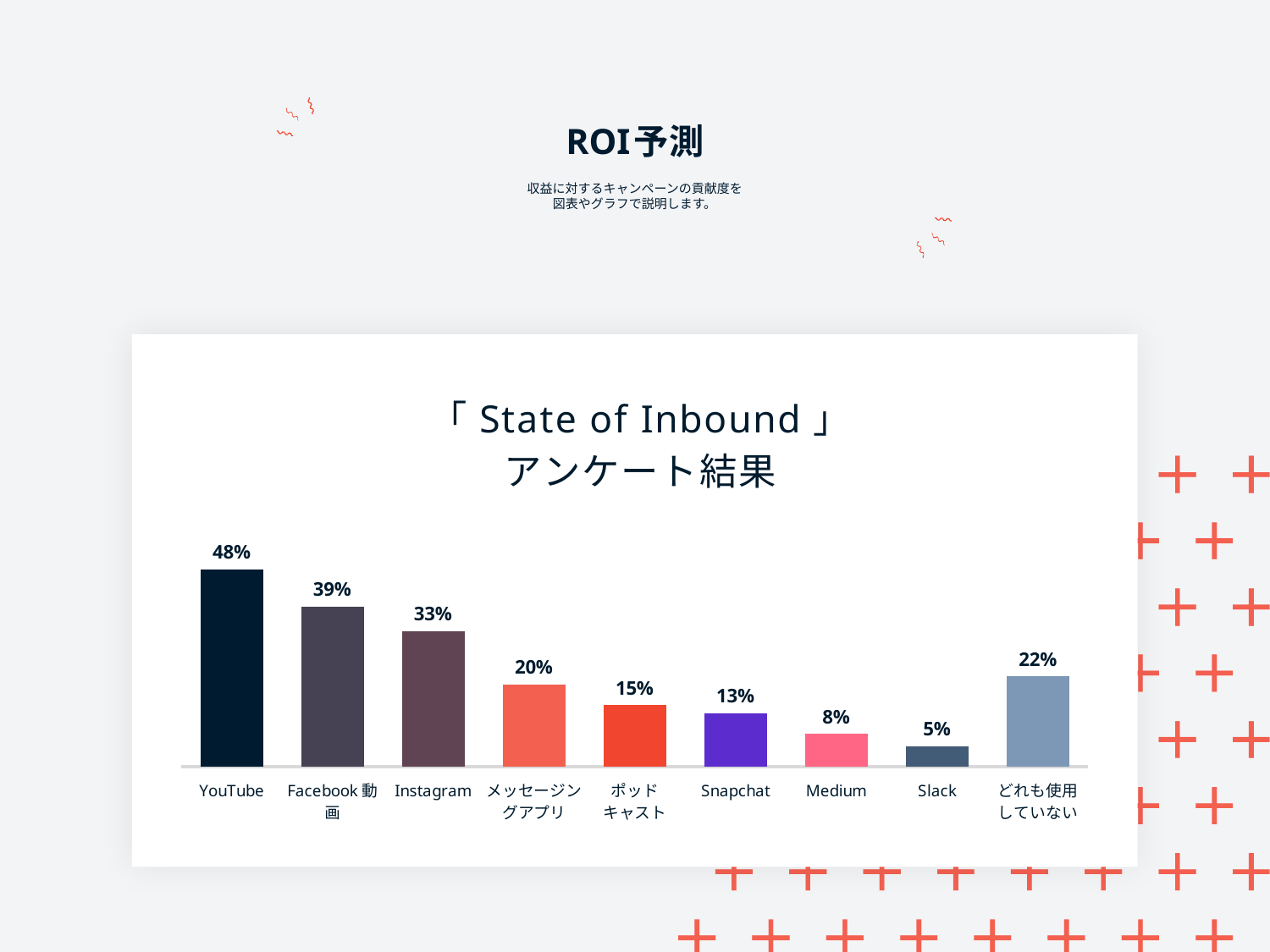
Which is larger, the value for ポッドキャスト or the value for どれも使用していない? どれも使用していない What kind of chart is shown on the slide? Bar chart What is the difference between the values for Instagram and Medium? 25% What is the value for どれも使用していない? 22% Which is larger, the value for メッセージングアプリ or the value for Snapchat? メッセージングアプリ What is the value for Snapchat? 13% What is the difference between the values for YouTube and Facebook 動画? 9% What is the title of the chart? 「 State of Inbound 」アンケート結果 How many categories are shown in the chart? 9 Which category has the highest value? YouTube What is the value for YouTube? 48% Which category has the lowest value? Slack